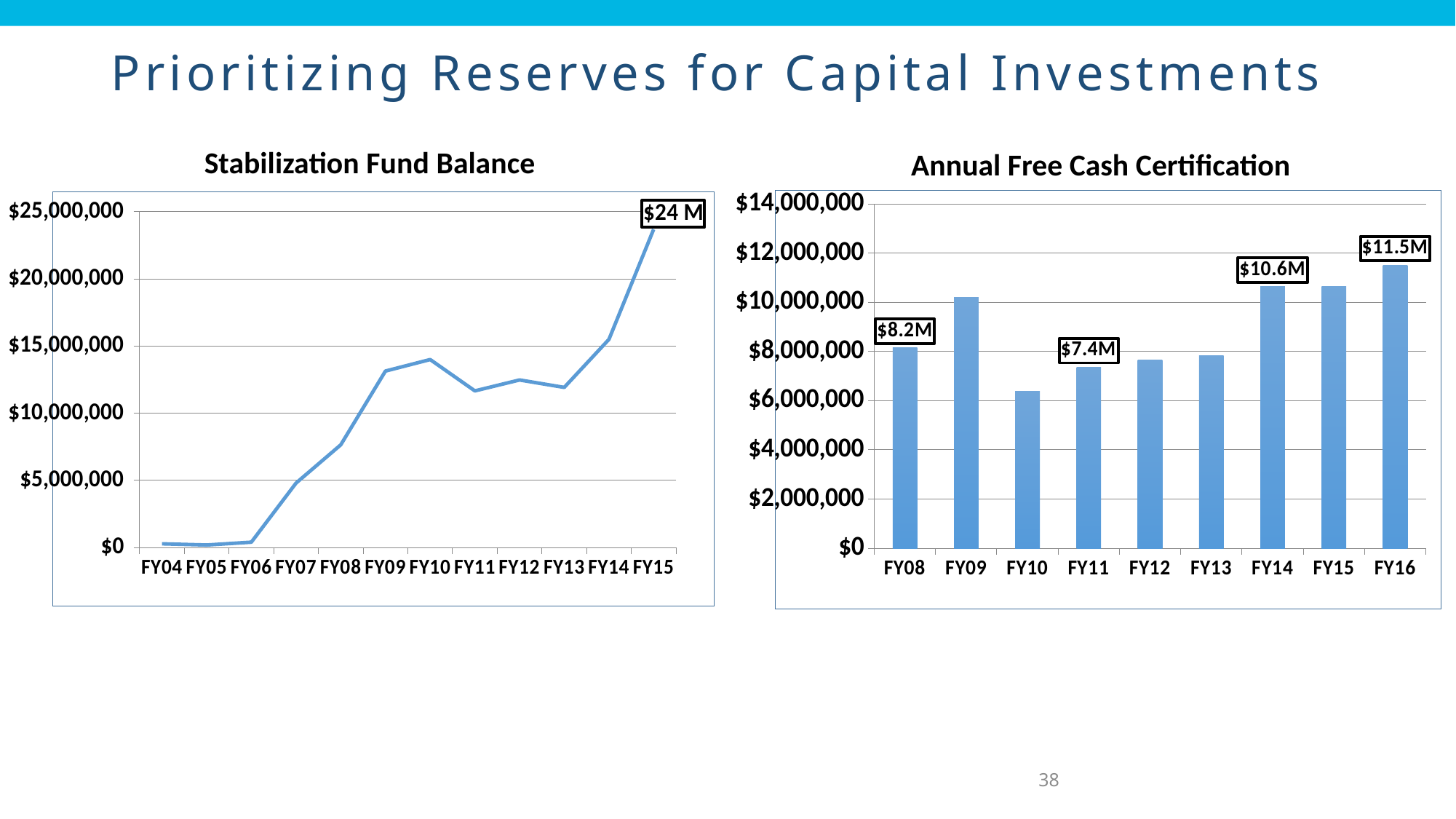
In the Stabilization Fund Balance chart, what kind of chart is shown? line chart In the Annual Free Cash Certification chart, how many fiscal years are shown? 9 In the Stabilization Fund Balance chart, is the value for FY08 greater or less than $10,000,000? less In the Annual Free Cash Certification chart, what is the value for FY08? $8.2M In the Annual Free Cash Certification chart, what is the value for FY16? $11.5M In the Annual Free Cash Certification chart, is the value for FY10 greater or less than $8,000,000? less In the Annual Free Cash Certification chart, which fiscal year has the lowest value? FY10 In the Stabilization Fund Balance chart, how many fiscal years are shown on the x axis? 12 In the Annual Free Cash Certification chart, which fiscal year has the highest value? FY16 In the Annual Free Cash Certification chart, what is the value for FY11? $7.4M In the Annual Free Cash Certification chart, what kind of chart is shown? bar chart In the Stabilization Fund Balance chart, what value is labelled for FY15? $24 M